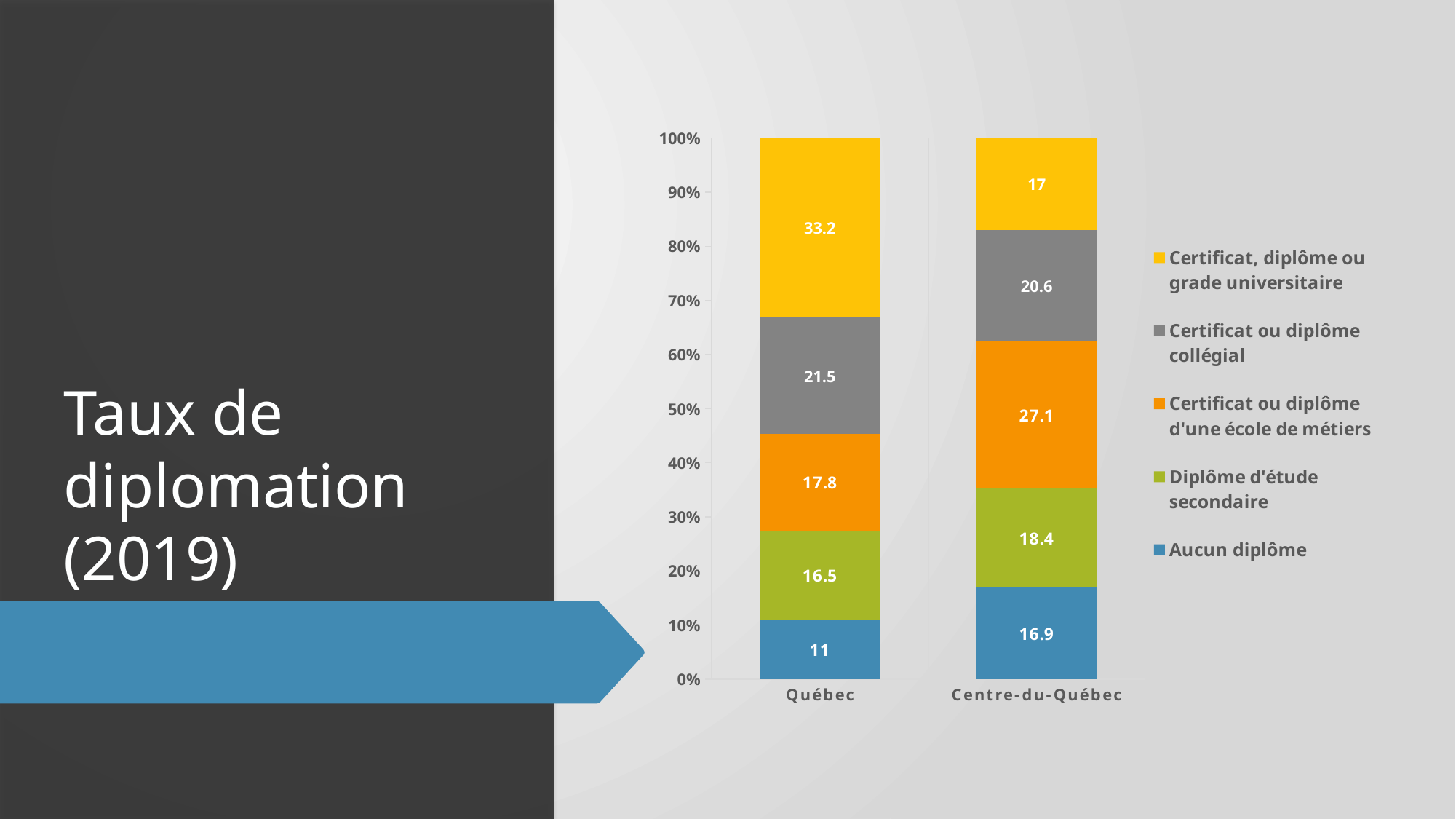
Which series has the smallest value in the Centre-du-Québec bar? Aucun diplôme What is the value for "Aucun diplôme" for Centre-du-Québec? 16.9 What is the title of the slide? Taux de diplomation (2019) How many series does the legend list? 5 Which series has the largest value in the Québec bar? Certificat, diplôme ou grade universitaire Which has a larger value for "Certificat ou diplôme collégial": Québec or Centre-du-Québec? Québec What kind of chart is shown on the slide? Stacked bar chart What is the value for "Certificat, diplôme ou grade universitaire" for Québec? 33.2 What is the value for "Diplôme d'étude secondaire" for Québec? 16.5 What is the value for "Certificat ou diplôme d'une école de métiers" for Centre-du-Québec? 27.1 How many categories are shown on the x axis? 2 What is the difference between the "Certificat, diplôme ou grade universitaire" values for Québec and Centre-du-Québec? 16.2